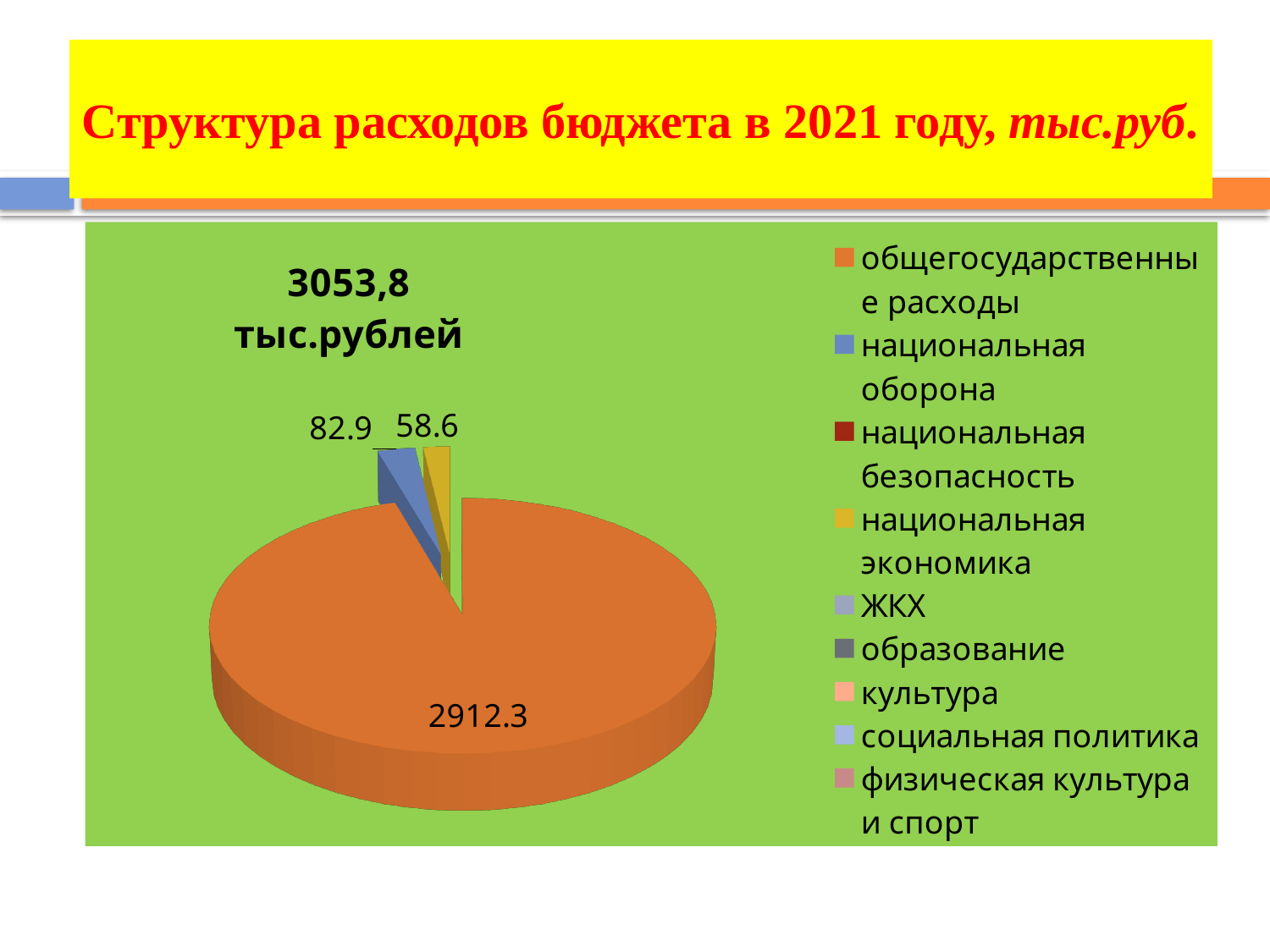
What value is shown for the национальная оборона slice? 82.9 Which category has the largest slice of the pie? общегосударственные расходы What is the difference between the национальная оборона value and the национальная экономика value? 24.3 What total amount is printed above the pie chart? 3053,8 тыс.рублей What kind of chart is shown on the slide? pie chart What is the difference between the общегосударственные расходы value and the национальная оборона value? 2829.4 What value is shown for the общегосударственные расходы slice of the pie chart? 2912.3 Of the labelled slices, which has the smallest value? национальная экономика How many categories does the legend list? 9 Which is larger, the value for национальная оборона or for национальная экономика? национальная оборона What value is shown for the национальная экономика slice? 58.6 What is the title of the slide? Структура расходов бюджета в 2021 году, тыс.руб.